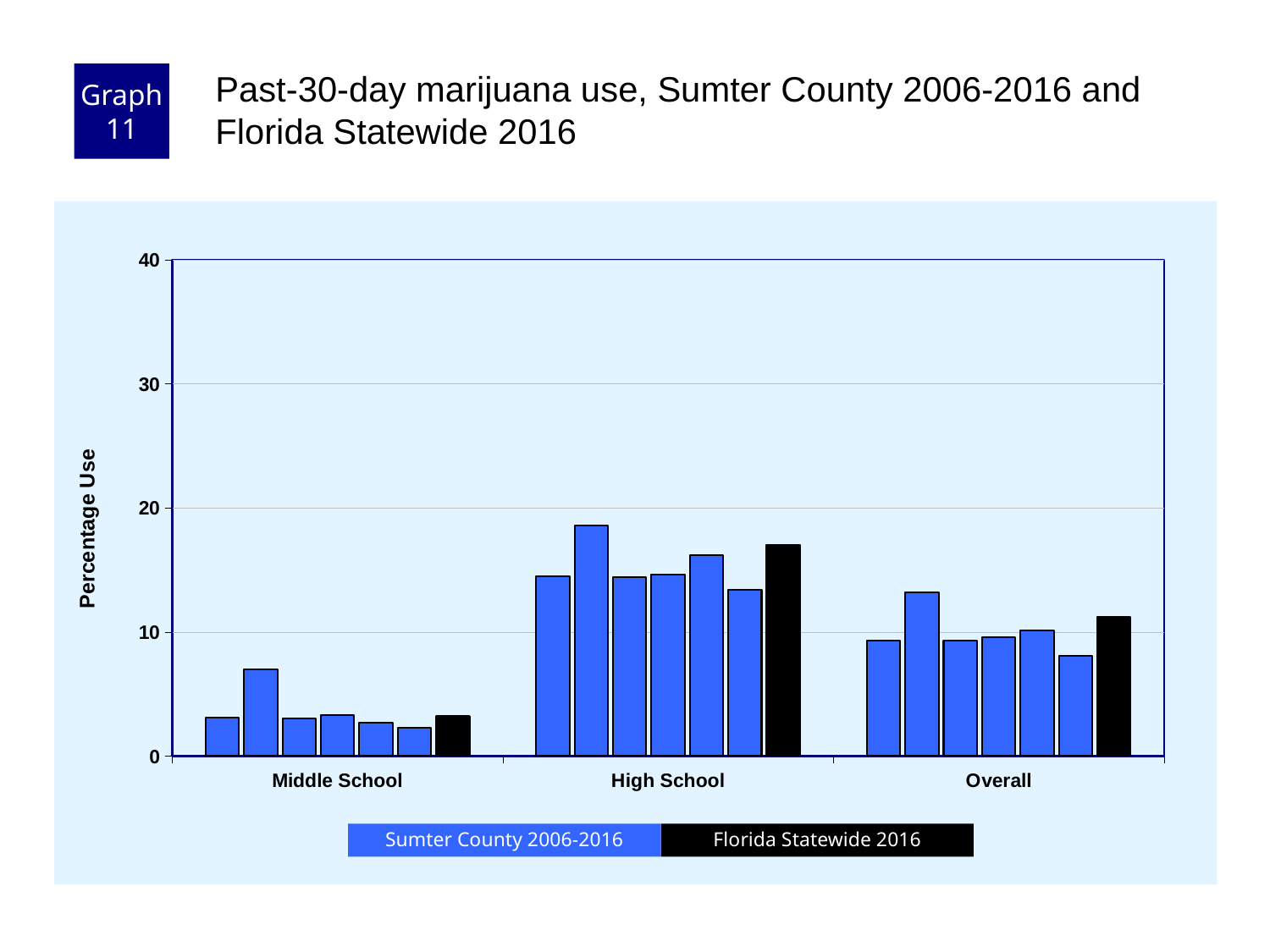
Is the Florida Statewide 2016 value for Middle School greater or less than 10? less Is the Florida Statewide 2016 value for Overall greater or less than 20? less Which category group has the shortest bars overall? Middle School How many categories are shown along the x axis? 3 Is the Florida Statewide 2016 value for High School greater or less than 10? greater What kind of chart is shown on the slide? bar chart What is the label on the y axis? Percentage Use How many series does the legend list? 2 Which category group has the tallest bars overall? High School Which is larger, the Florida Statewide 2016 value for High School or for Middle School? High School How many bars are plotted in the High School group? 7